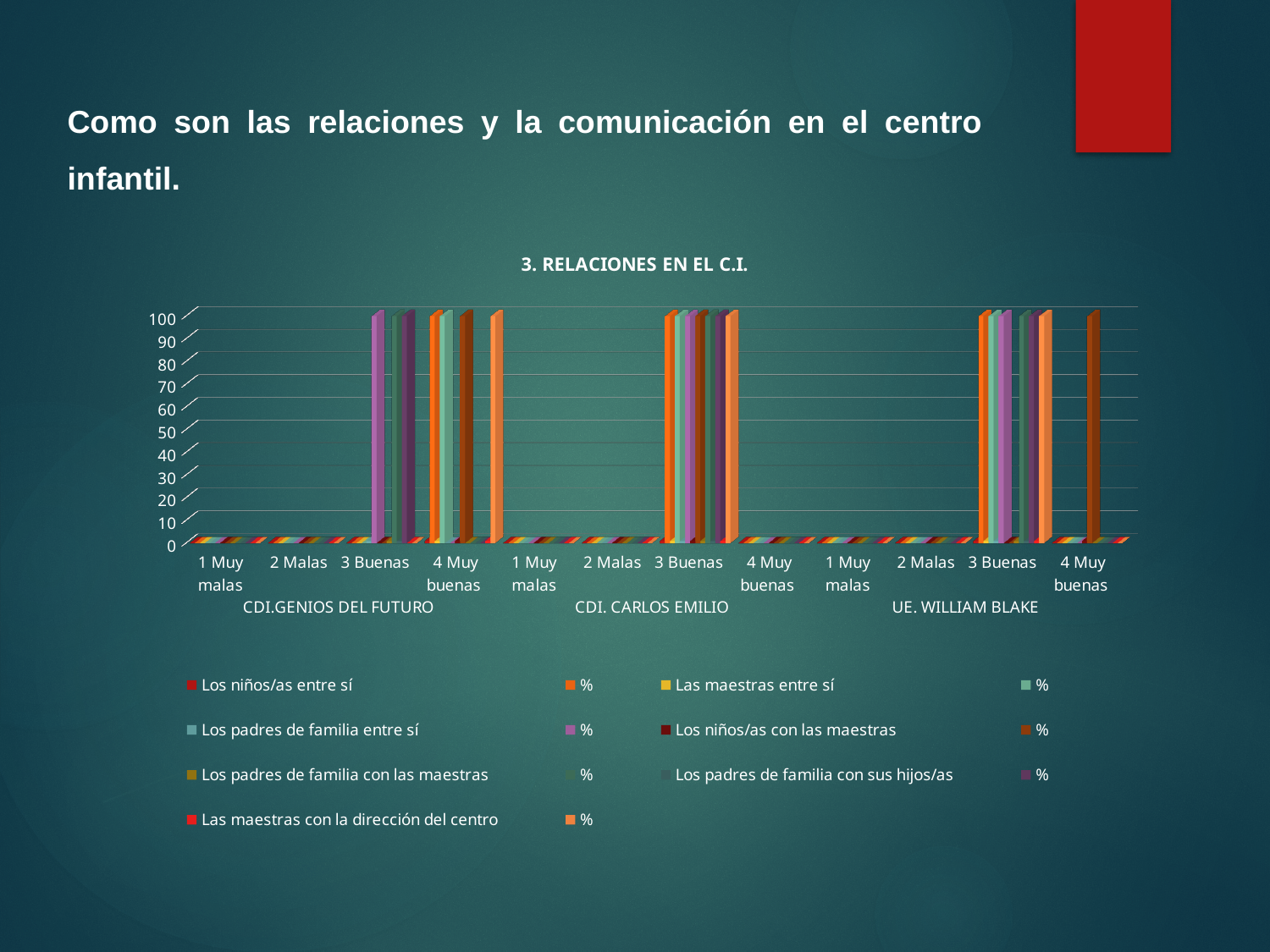
How many entries does the chart legend list? 14 What kind of chart is shown on the slide? bar chart Under CDI.GENIOS DEL FUTURO, which category has taller bars: '2 Malas' or '3 Buenas'? 3 Buenas What is the highest tick value shown on the vertical axis? 100 Are the bars for '1 Muy malas' under CDI.GENIOS DEL FUTURO greater or less than 20? less Under CDI. CARLOS EMILIO, which category has taller bars: '3 Buenas' or '1 Muy malas'? 3 Buenas How many rating categories are shown for each centre on the x axis? 4 Are the bars for '2 Malas' under CDI. CARLOS EMILIO greater or less than 50? less Are the tallest bars for '3 Buenas' under UE. WILLIAM BLAKE greater or less than 50? greater What is the title of the chart? 3. RELACIONES EN EL C.I. How many centres (groups) are shown along the x axis of the chart? 3